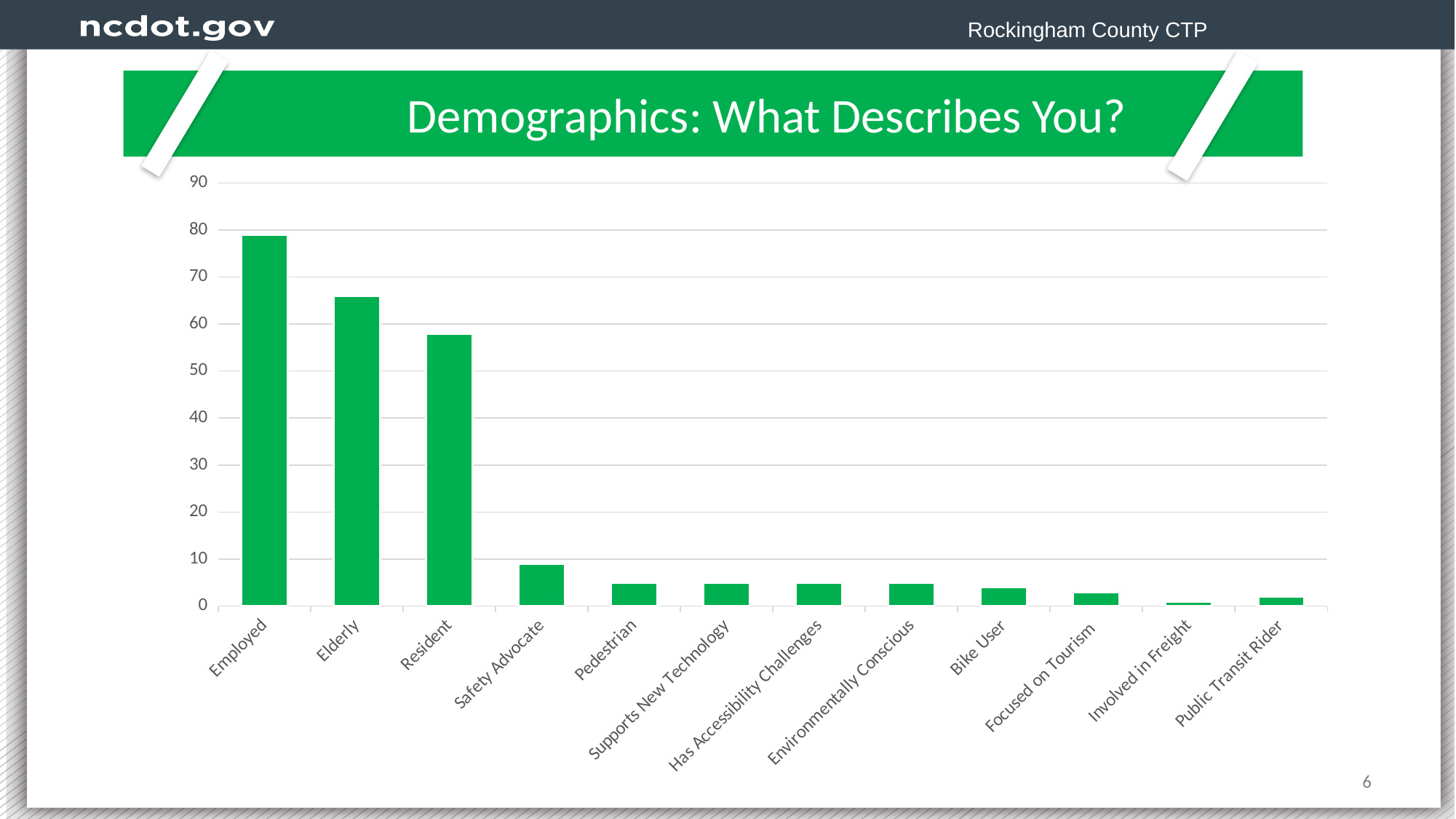
Is the value for Employed greater or less than 70? greater Which category has the highest value in the chart? Employed Is the value for Resident greater or less than 60? less What kind of chart is shown on the slide? bar chart Is the value for Elderly greater or less than 60? greater What is the title of the chart on the slide? Demographics: What Describes You? Which is larger, the value for Safety Advocate or the value for Pedestrian? Safety Advocate Do the values generally rise or fall moving from left to right along the x axis? fall How many categories are shown on the x axis of the chart? 12 Which is larger, the value for Elderly or the value for Resident? Elderly